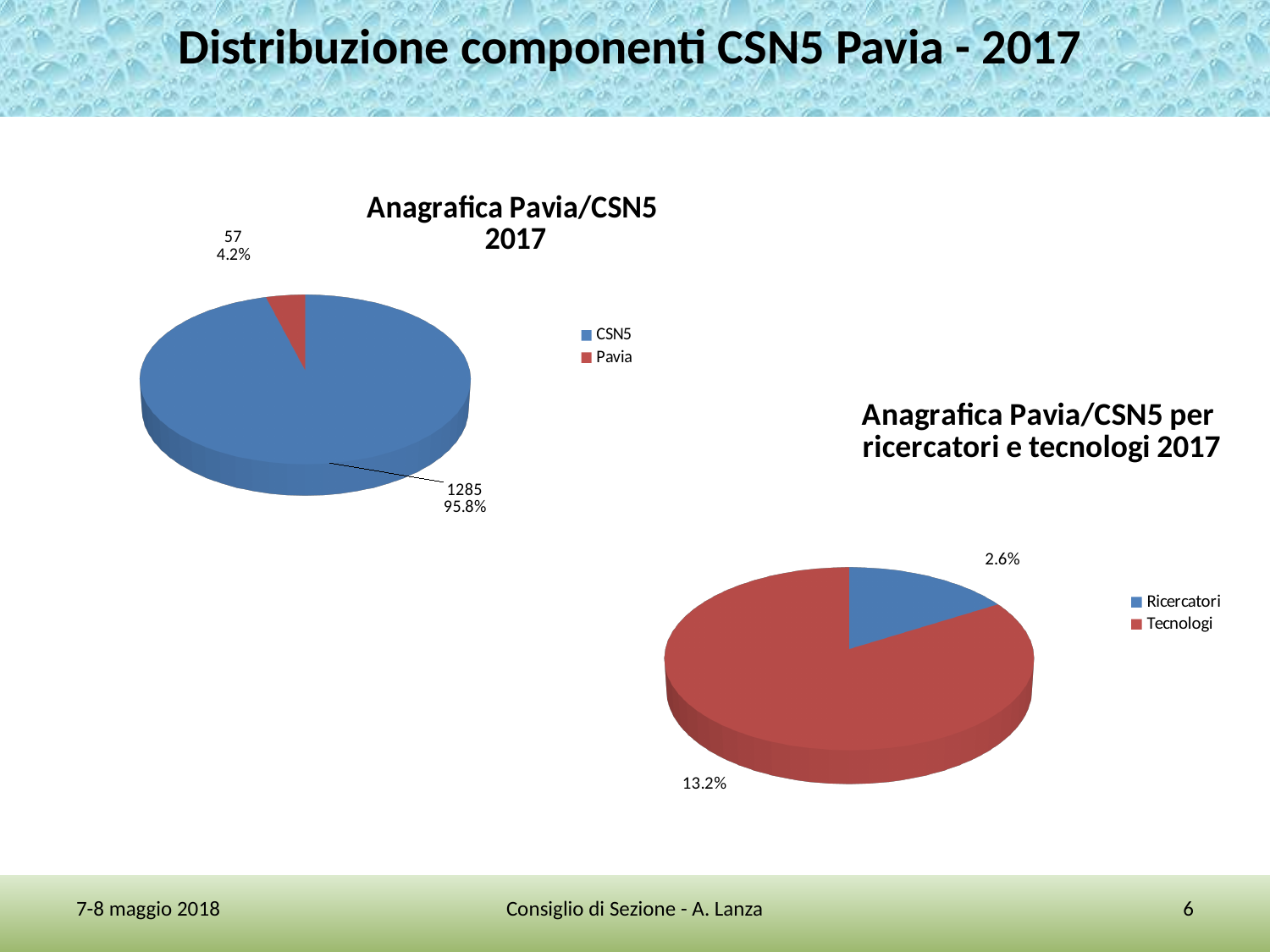
In the chart titled "Anagrafica Pavia/CSN5 per ricercatori e tecnologi 2017", what percentage is shown for Ricercatori? 2.6% In the chart titled "Anagrafica Pavia/CSN5 2017", what is the total of the two slice values? 1342 In the chart titled "Anagrafica Pavia/CSN5 2017", what value is shown for Pavia? 57 In the chart titled "Anagrafica Pavia/CSN5 2017", what percentage share does the Pavia slice have? 4.2% In the chart titled "Anagrafica Pavia/CSN5 2017", what value is shown for CSN5? 1285 In the chart titled "Anagrafica Pavia/CSN5 per ricercatori e tecnologi 2017", what percentage is shown for Tecnologi? 13.2% What kind of chart is "Anagrafica Pavia/CSN5 per ricercatori e tecnologi 2017"? Pie chart How many entries does the legend of the chart titled "Anagrafica Pavia/CSN5 2017" list? 2 In the chart titled "Anagrafica Pavia/CSN5 2017", what is the difference between the CSN5 value and the Pavia value? 1228 In the chart titled "Anagrafica Pavia/CSN5 2017", which category has the largest slice? CSN5 In the chart titled "Anagrafica Pavia/CSN5 per ricercatori e tecnologi 2017", which category has the smaller slice? Ricercatori In the chart titled "Anagrafica Pavia/CSN5 2017", what percentage share does the CSN5 slice have? 95.8%